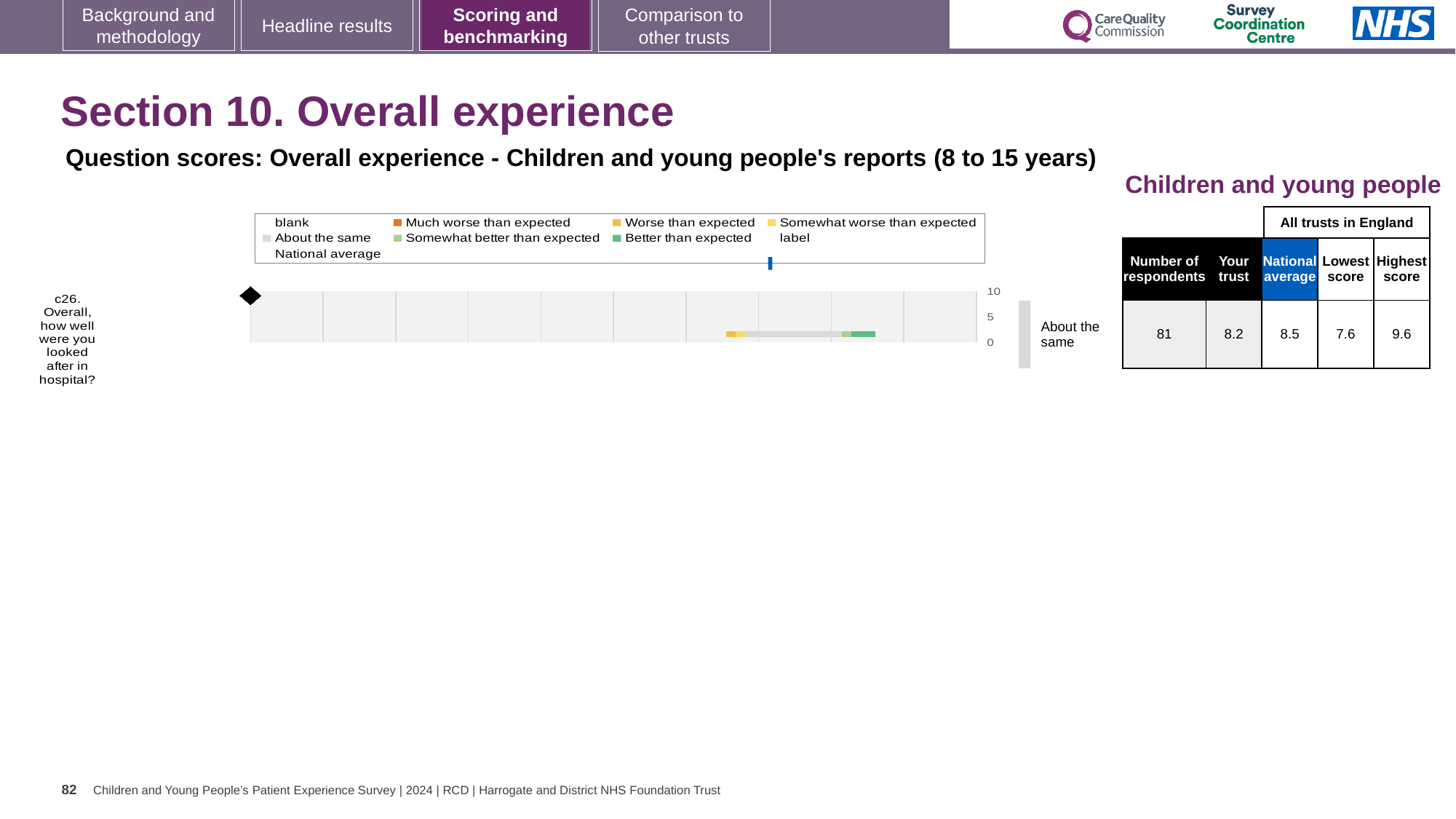
What benchmark result label is shown to the right of the chart for question c26? About the same What is the difference between the Highest score and the Lowest score for question c26 in the table beside the chart? 2.0 Which question is plotted in the chart? c26. Overall, how well were you looked after in hospital? How many question categories are plotted in the chart? 1 In the table beside the chart, what is the Highest score among all trusts in England for question c26? 9.6 Which is larger for question c26: the 'Your trust' score or the National average? National average In the table beside the chart, what is the 'Your trust' score for question c26? 8.2 What is the highest tick value shown on the chart's axis? 10 What kind of chart is shown on the slide? Bar chart In the table beside the chart, what is the National average score for question c26? 8.5 In the table beside the chart, how many respondents answered question c26? 81 In the table beside the chart, what is the Lowest score among all trusts in England for question c26? 7.6